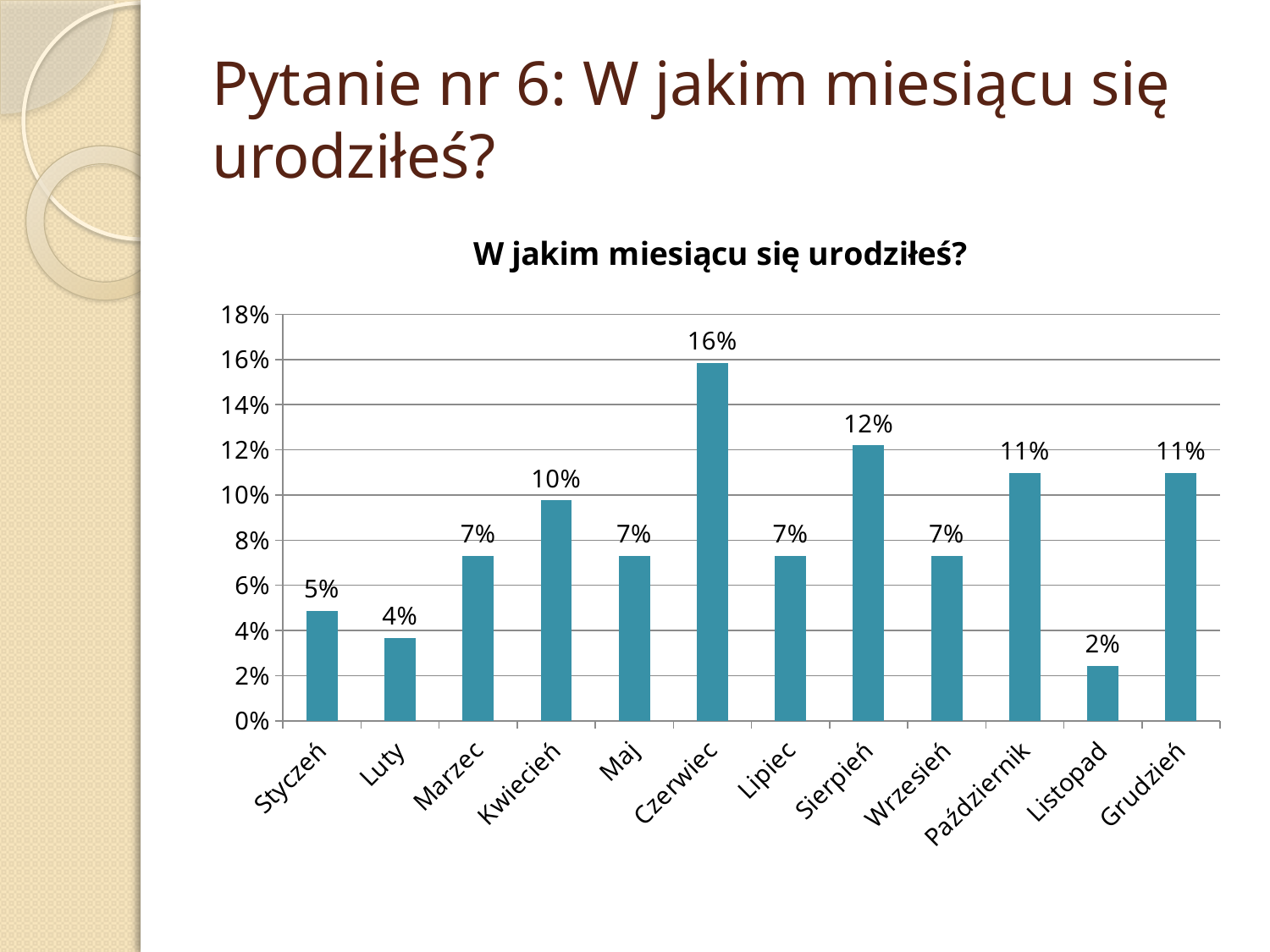
Which month has the highest value? Czerwiec How many months are shown on the x axis? 12 What is the value for Listopad? 2% What is the value for Kwiecień? 10% What is the value for Czerwiec? 16% What is the title of the chart? W jakim miesiącu się urodziłeś? What is the difference between the values for Czerwiec and Sierpień? 4% Which month has the lowest value? Listopad What is the highest value shown on the y axis? 18% What kind of chart is shown on the slide? bar chart Is the value for Październik greater or less than 10%? greater Which is larger, the value for Styczeń or the value for Luty? Styczeń